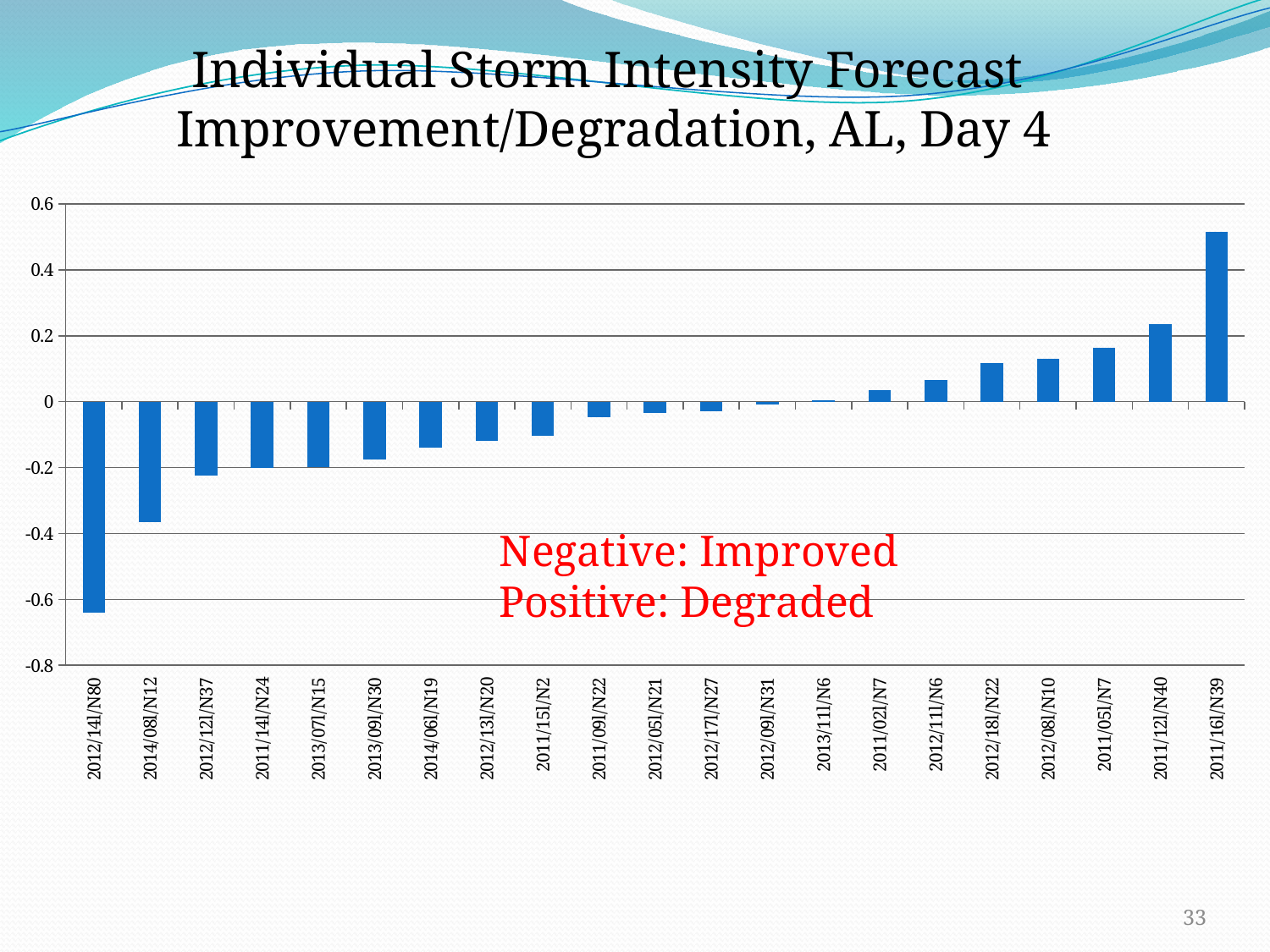
What kind of chart is shown on the slide? bar chart Is the value for 2014/08l/N12 greater or less than -0.2? less Is the value for 2012/14l/N80 greater or less than -0.6? less According to the red annotation on the chart, what does a negative value indicate? Improved Is the value for 2013/09l/N30 greater or less than -0.2? greater Do the values generally rise or fall moving from left to right along the x axis? rise Which storm has the lowest value? 2012/14l/N80 Which has the larger value, 2011/16l/N39 or 2011/12l/N40? 2011/16l/N39 Which storm has the highest value? 2011/16l/N39 How many storm categories are plotted along the x axis? 21